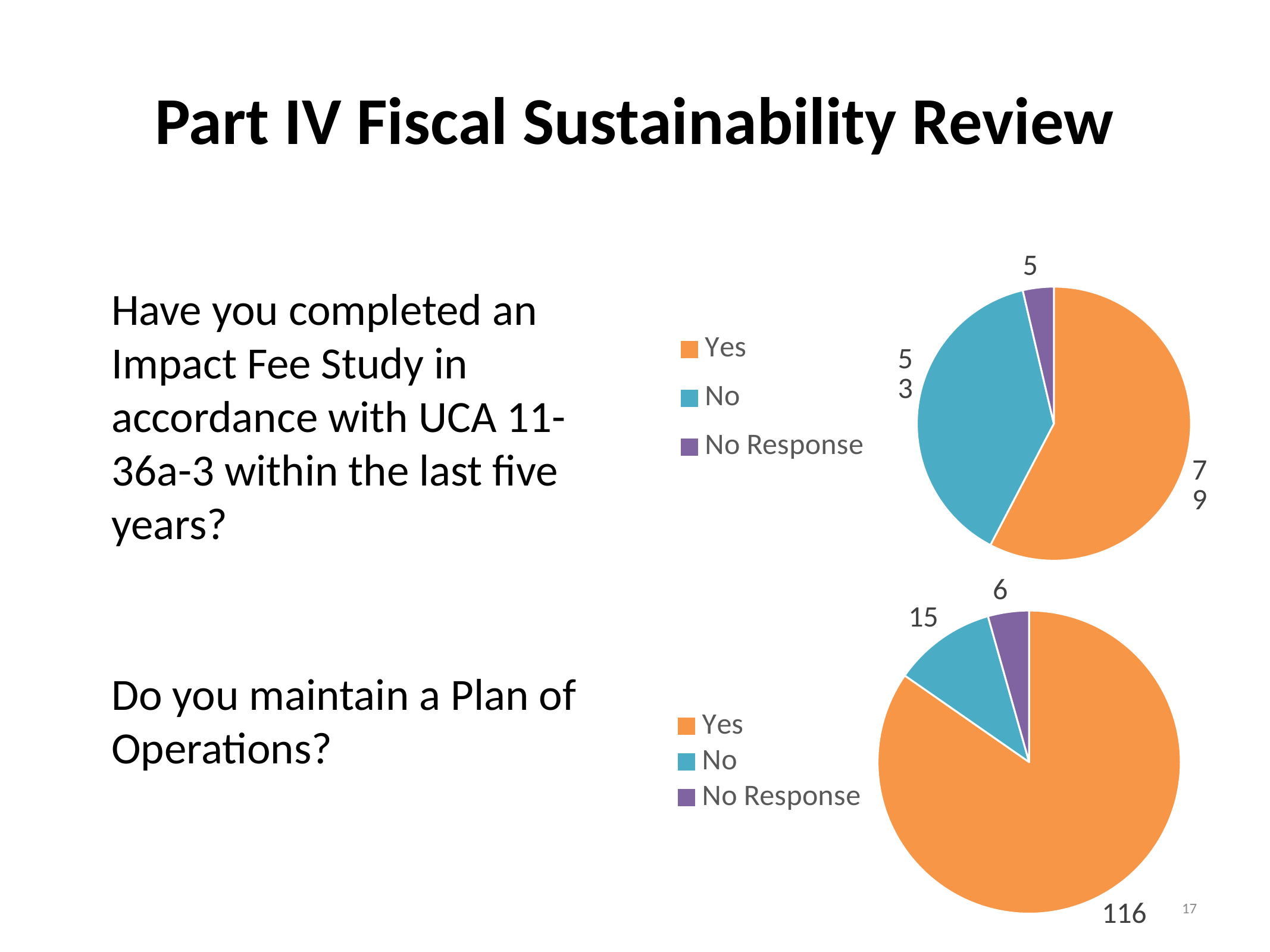
In the top pie chart (Impact Fee Study), which category has the largest slice? Yes In the bottom pie chart (Plan of Operations), what is the value for No Response? 6 In the bottom pie chart (Plan of Operations), which is larger, No or No Response? No In the top pie chart (Impact Fee Study), how many respondents answered No? 53 In the bottom pie chart (Plan of Operations), how many respondents answered No? 15 How many categories does the legend of the bottom pie chart list? 3 In the top pie chart (Impact Fee Study), what is the difference between the Yes and No values? 26 In the bottom pie chart (Plan of Operations), which category has the smallest slice? No Response In the top pie chart (Impact Fee Study), what is the value for No Response? 5 What type of chart is used for the Plan of Operations question? Pie chart In the bottom pie chart (Plan of Operations), how many respondents answered Yes? 116 In the top pie chart (Impact Fee Study), how many respondents answered Yes? 79